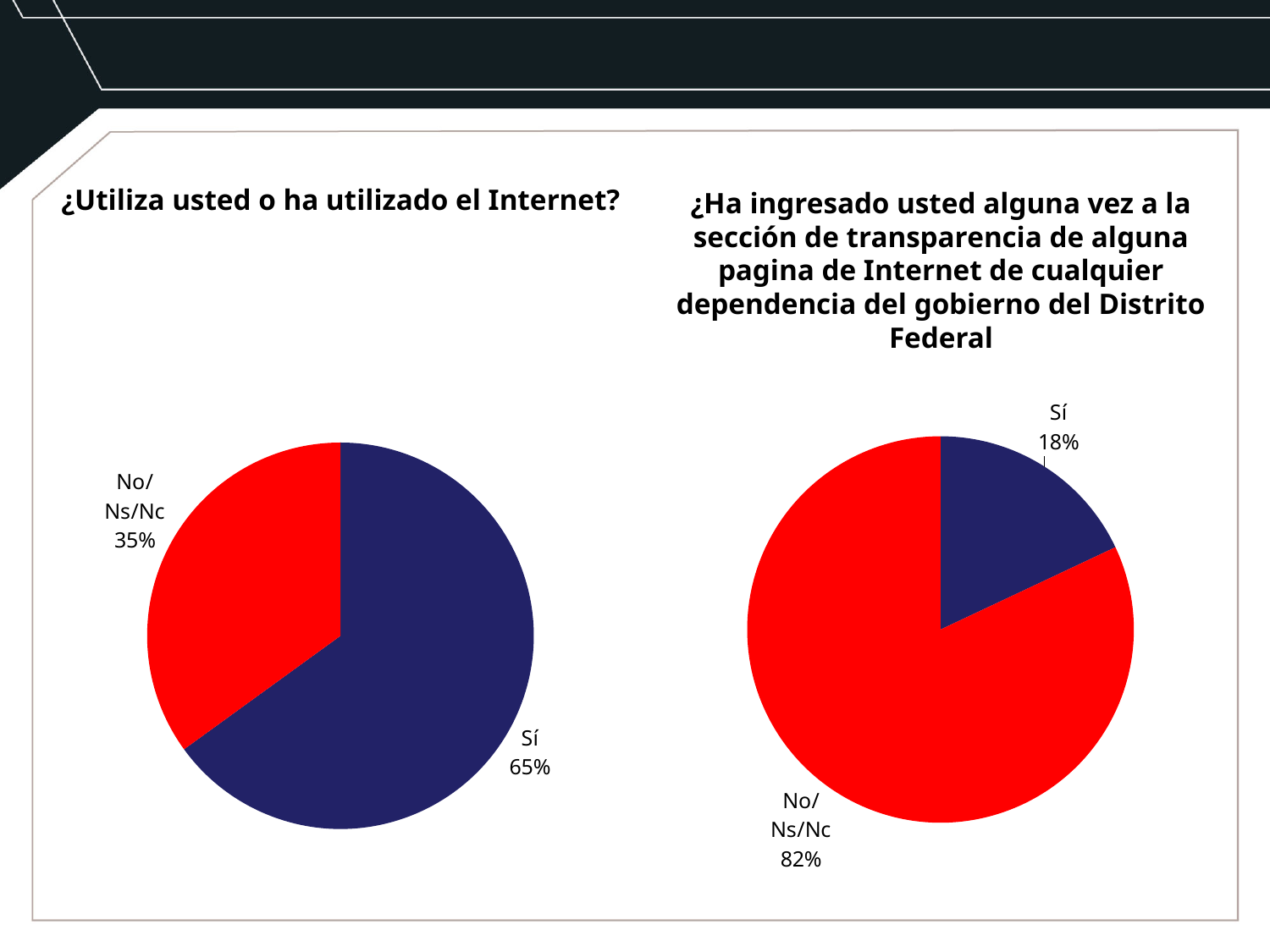
In the left chart (¿Utiliza usted o ha utilizado el Internet?), what share of respondents answered Sí? 65% In the left chart (¿Utiliza usted o ha utilizado el Internet?), what share of respondents answered No/Ns/Nc? 35% How many slices does the left chart (¿Utiliza usted o ha utilizado el Internet?) have? 2 In the right chart (¿Ha ingresado usted alguna vez a la sección de transparencia...), what share of respondents answered No/Ns/Nc? 82% In the left chart (¿Utiliza usted o ha utilizado el Internet?), what is the difference in percentage points between Sí and No/Ns/Nc? 30 percentage points In the right chart (¿Ha ingresado usted alguna vez a la sección de transparencia...), what share of respondents answered Sí? 18% Which is larger: the Sí share in the left chart or the Sí share in the right chart? The Sí share in the left chart (65%) In the right chart (¿Ha ingresado usted alguna vez a la sección de transparencia...), what is the difference in percentage points between No/Ns/Nc and Sí? 64 percentage points In the right chart (¿Ha ingresado usted alguna vez a la sección de transparencia...), which slice is the smallest? Sí In the left chart (¿Utiliza usted o ha utilizado el Internet?), which slice is the largest? Sí What type of chart is used on the right side of the slide? Pie chart In the right chart (¿Ha ingresado usted alguna vez a la sección de transparencia...), what colour is the No/Ns/Nc slice? Red